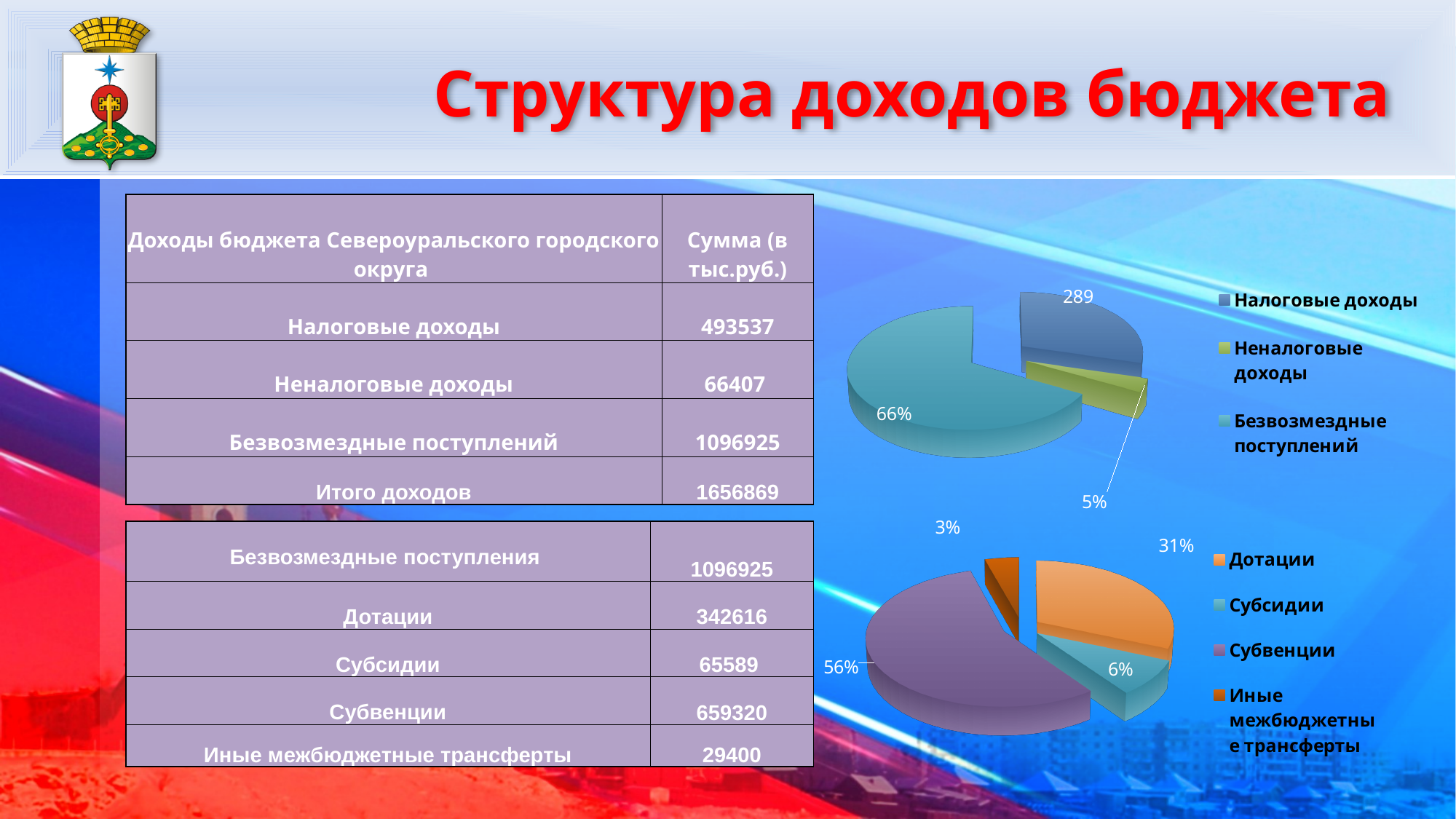
In the top pie chart, what share is shown for Безвозмездные поступлений? 66% In the bottom pie chart, what share is shown for Иные межбюджетные трансферты? 3% How many categories does the bottom pie chart show? 4 In the top pie chart, what share is shown for Неналоговые доходы? 5% In the bottom pie chart, which category has the largest slice? Субвенции How many entries does the legend of the top pie chart list? 3 In the top pie chart, which category has the largest slice? Безвозмездные поступлений In the bottom pie chart, what is the difference in percentage points between Субвенции and Дотации? 25 What kind of chart is the top chart on the right side of the slide? pie chart In the top pie chart, which category has the smallest slice? Неналоговые доходы